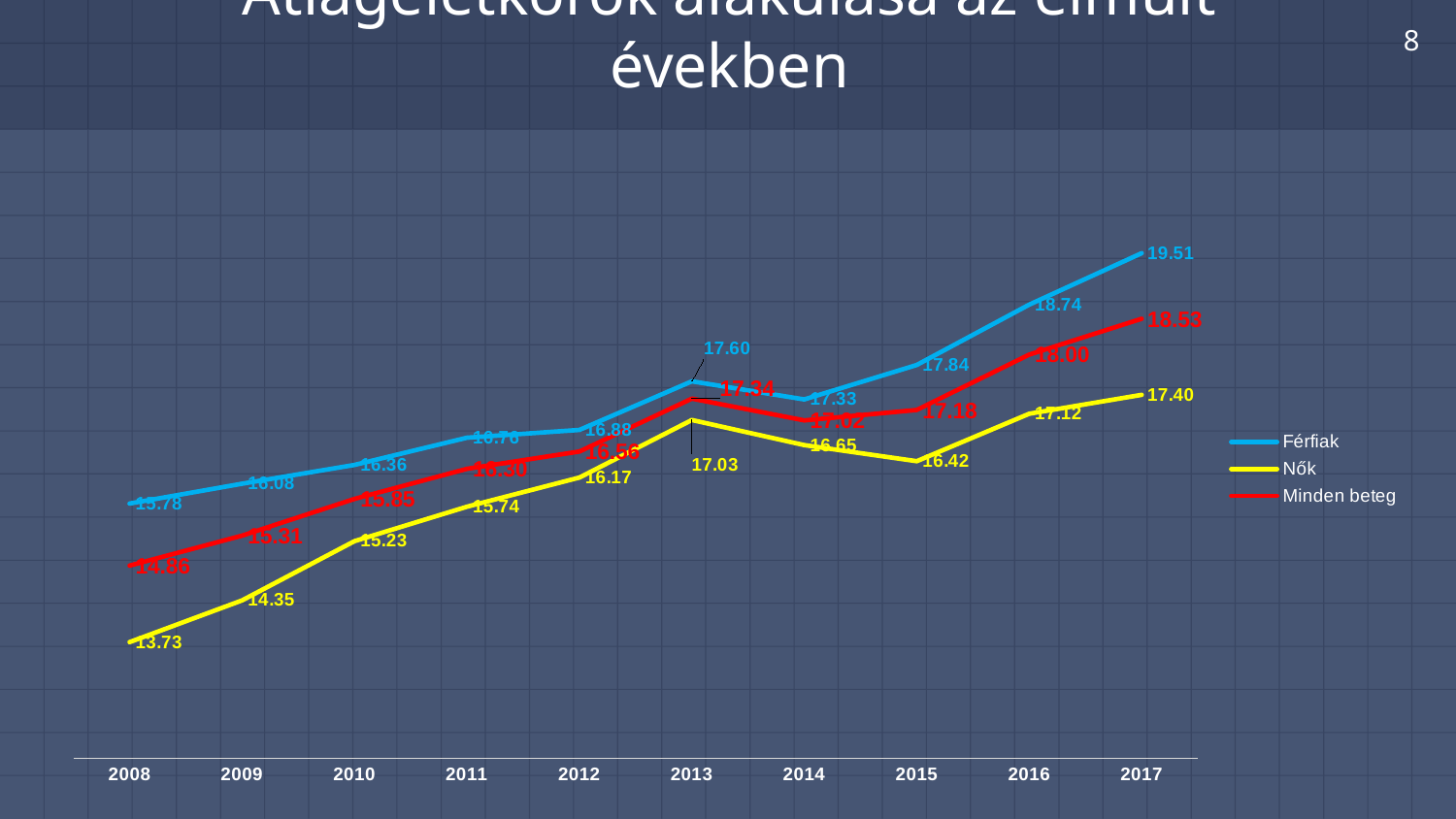
Does the Férfiak series generally rise or fall from 2008 to 2017? rise How many years are shown on the x axis? 10 What is the value for Nők in 2008? 13.73 In which year is the Nők series lowest? 2008 What is the value for Férfiak in 2017? 19.51 What type of chart is shown on the slide? line chart What is the difference between the Férfiak value in 2017 and the Férfiak value in 2008? 3.73 What is the value for Minden beteg in 2017? 18.53 How many series does the legend list? 3 In which year is the Férfiak series highest? 2017 What is the value for Nők in 2015? 16.42 Which is larger in 2016, the Férfiak value or the Nők value? Férfiak